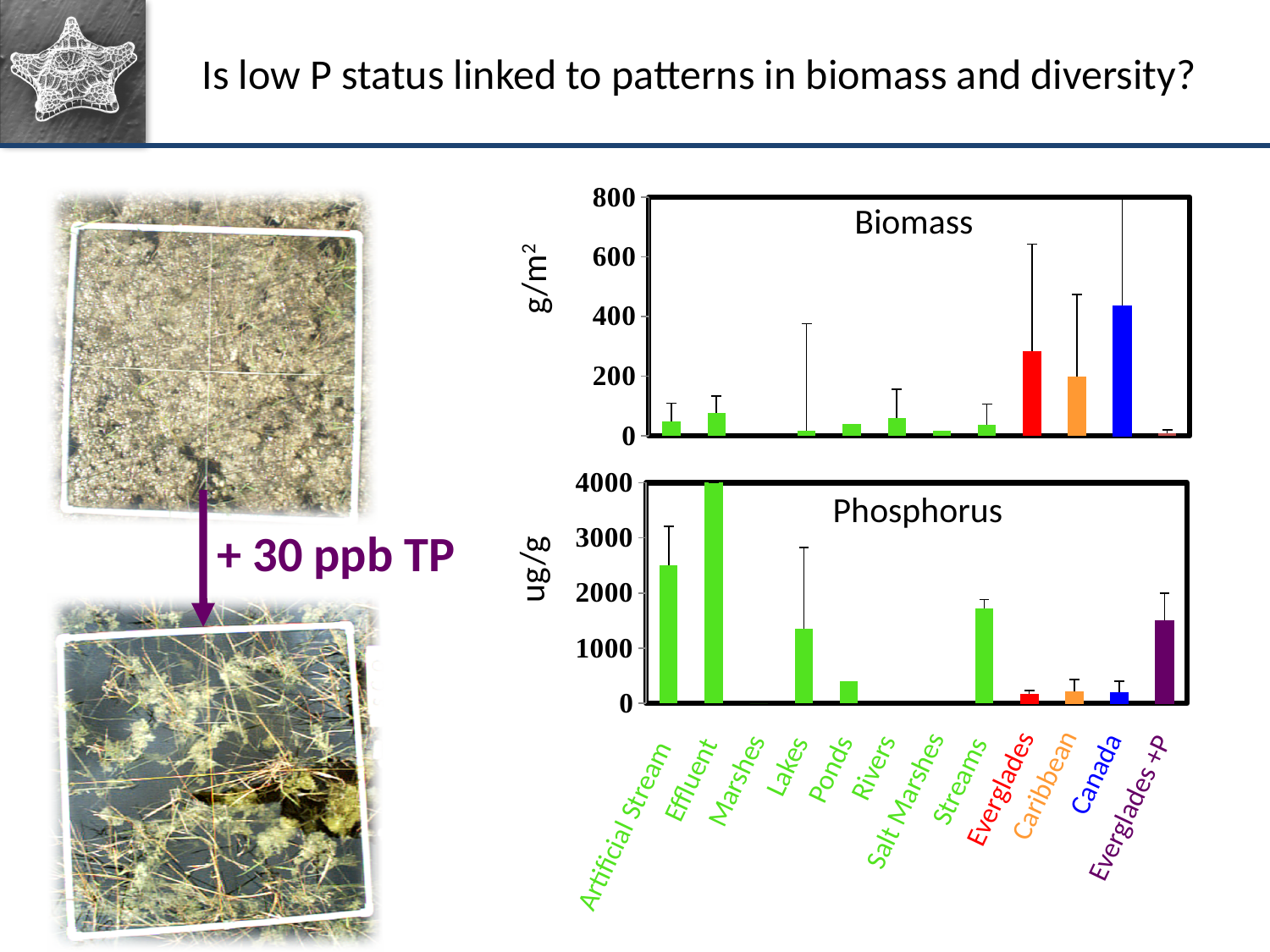
How many categories are labelled on the x axis shared by the two charts? 12 In the Biomass chart, is the value for Everglades greater or less than 200? greater In the Biomass chart, which category has the highest value? Canada In the Phosphorus chart, is the value for Everglades +P greater or less than 1000? greater In the Phosphorus chart, which is larger, the value for Streams or the value for Ponds? Streams In the Phosphorus chart, which category has the highest value? Effluent In the Phosphorus chart, is the value for Ponds greater or less than 1000? less What kind of chart is the Phosphorus chart? bar chart What unit is shown on the y axis of the Biomass chart? g/m² In the Biomass chart, which is larger, the value for Everglades or the value for Caribbean? Everglades